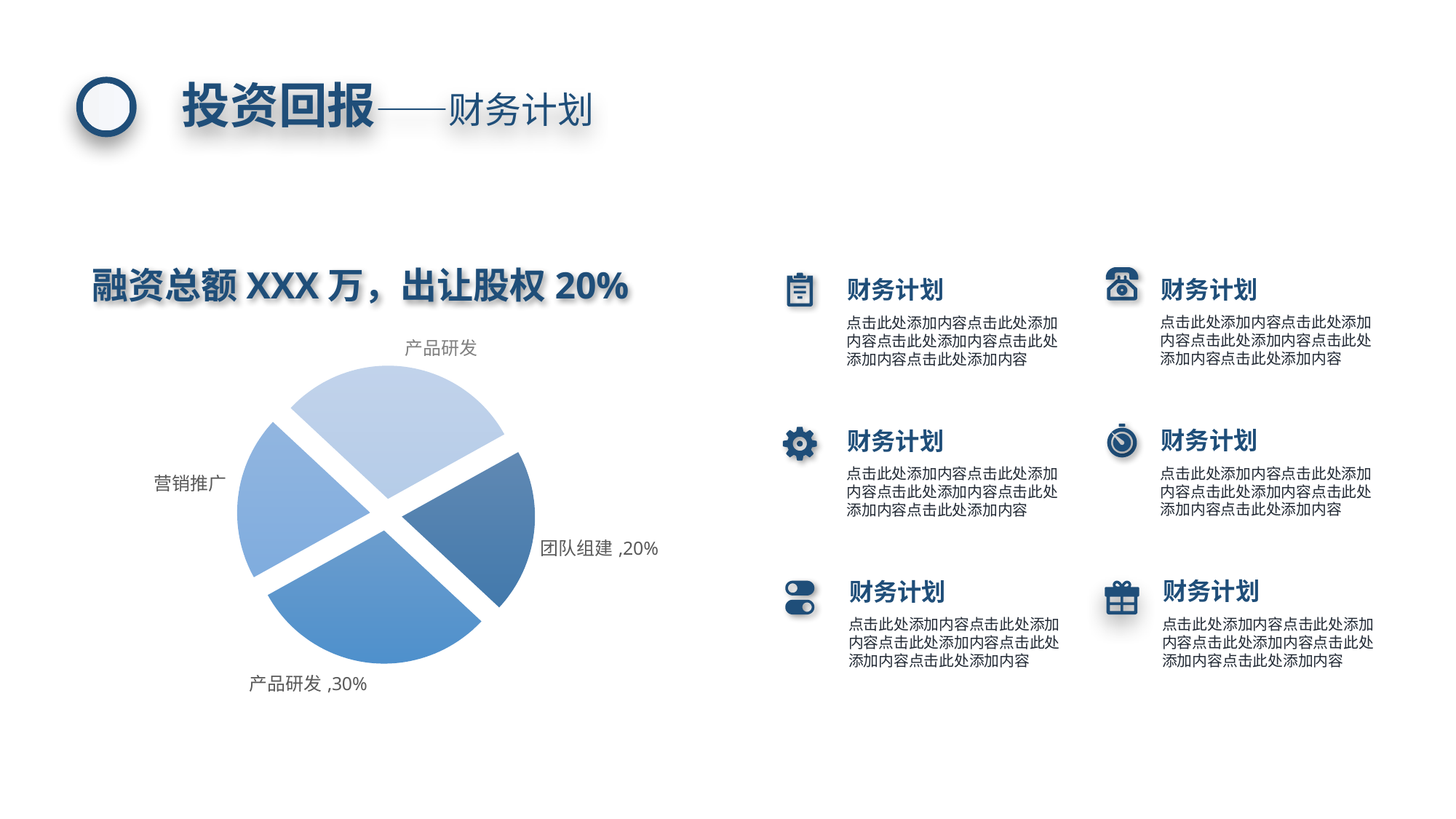
By how many percentage points does the bottom 产品研发 slice (30%) exceed the 团队组建 slice in the pie chart? 10 percentage points How many slices of the pie chart have a percentage printed in their label? 2 Which is larger in the pie chart: the 团队组建 slice or the bottom 产品研发 slice labelled with a percentage? 产品研发 What kind of chart is shown on the slide? pie chart What percentage is printed for the 团队组建 slice of the pie chart? 20% What is the label of the slice on the left side of the pie chart? 营销推广 How many slices does the pie chart have? 4 What percentage is printed next to the bottom 产品研发 slice of the pie chart? 30%